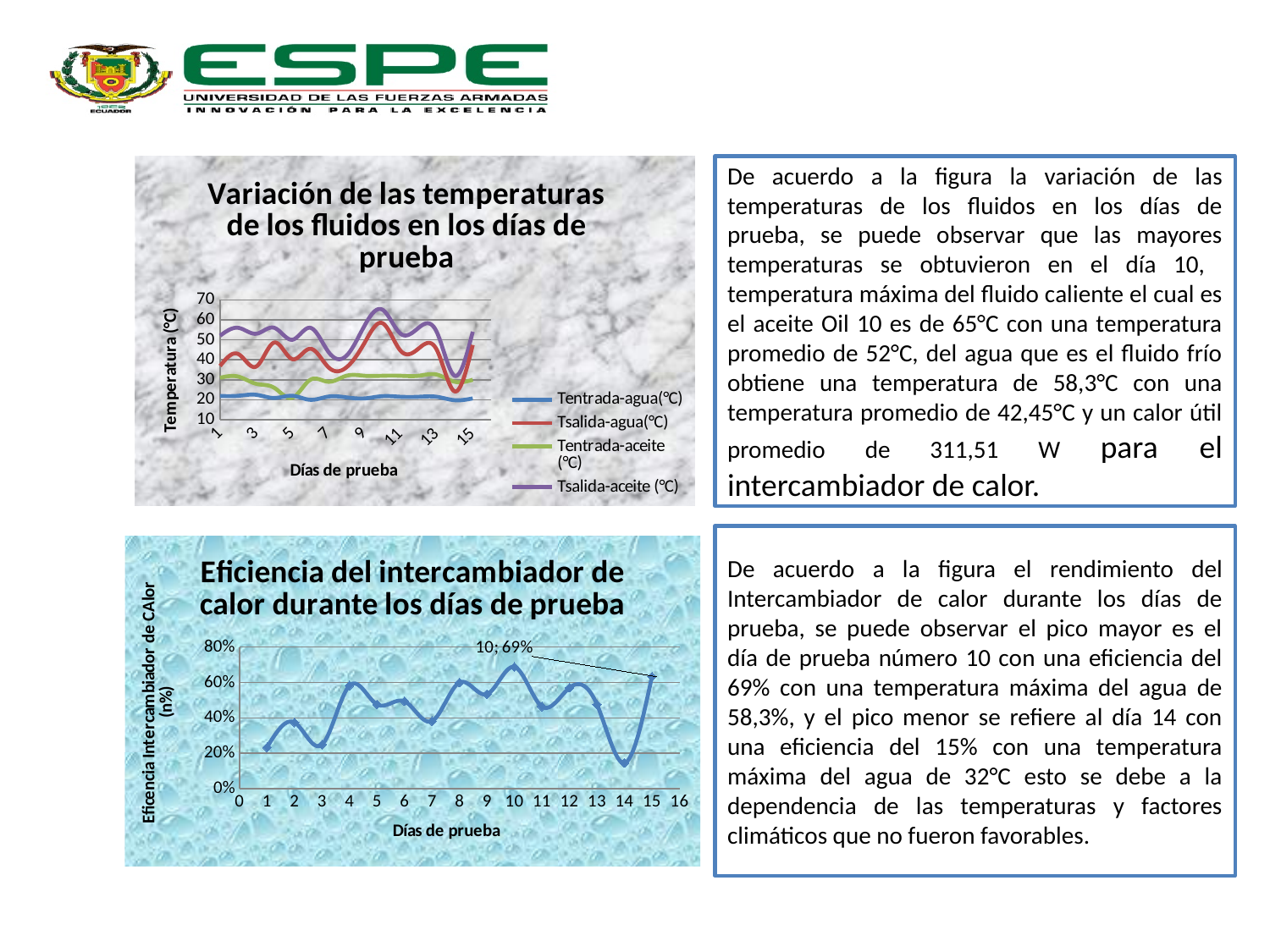
What kind of chart is the 'Eficiencia del intercambiador de calor durante los días de prueba' chart? line chart In the 'Eficiencia del intercambiador de calor durante los días de prueba' chart, is the efficiency on day 14 greater or less than 20%? less In the 'Eficiencia del intercambiador de calor durante los días de prueba' chart, on which day is the efficiency lowest? 14 In the 'Variación de las temperaturas de los fluidos en los días de prueba' chart, which is larger on day 10: Tsalida-aceite (°C) or Tentrada-agua(°C)? Tsalida-aceite (°C) In the 'Eficiencia del intercambiador de calor durante los días de prueba' chart, what is the efficiency on day 10? 69% In the 'Variación de las temperaturas de los fluidos en los días de prueba' chart, is the value of Tentrada-agua(°C) on day 1 greater or less than 30? less In the 'Eficiencia del intercambiador de calor durante los días de prueba' chart, on which day is the efficiency highest? 10 What kind of chart is the 'Variación de las temperaturas de los fluidos en los días de prueba' chart? line chart In the 'Variación de las temperaturas de los fluidos en los días de prueba' chart, is the value of Tsalida-aceite (°C) on day 10 greater or less than 60? greater In the 'Variación de las temperaturas de los fluidos en los días de prueba' chart, what is the label of the vertical axis? Temperatura (°C) How many series does the legend of the 'Variación de las temperaturas de los fluidos en los días de prueba' chart list? 4